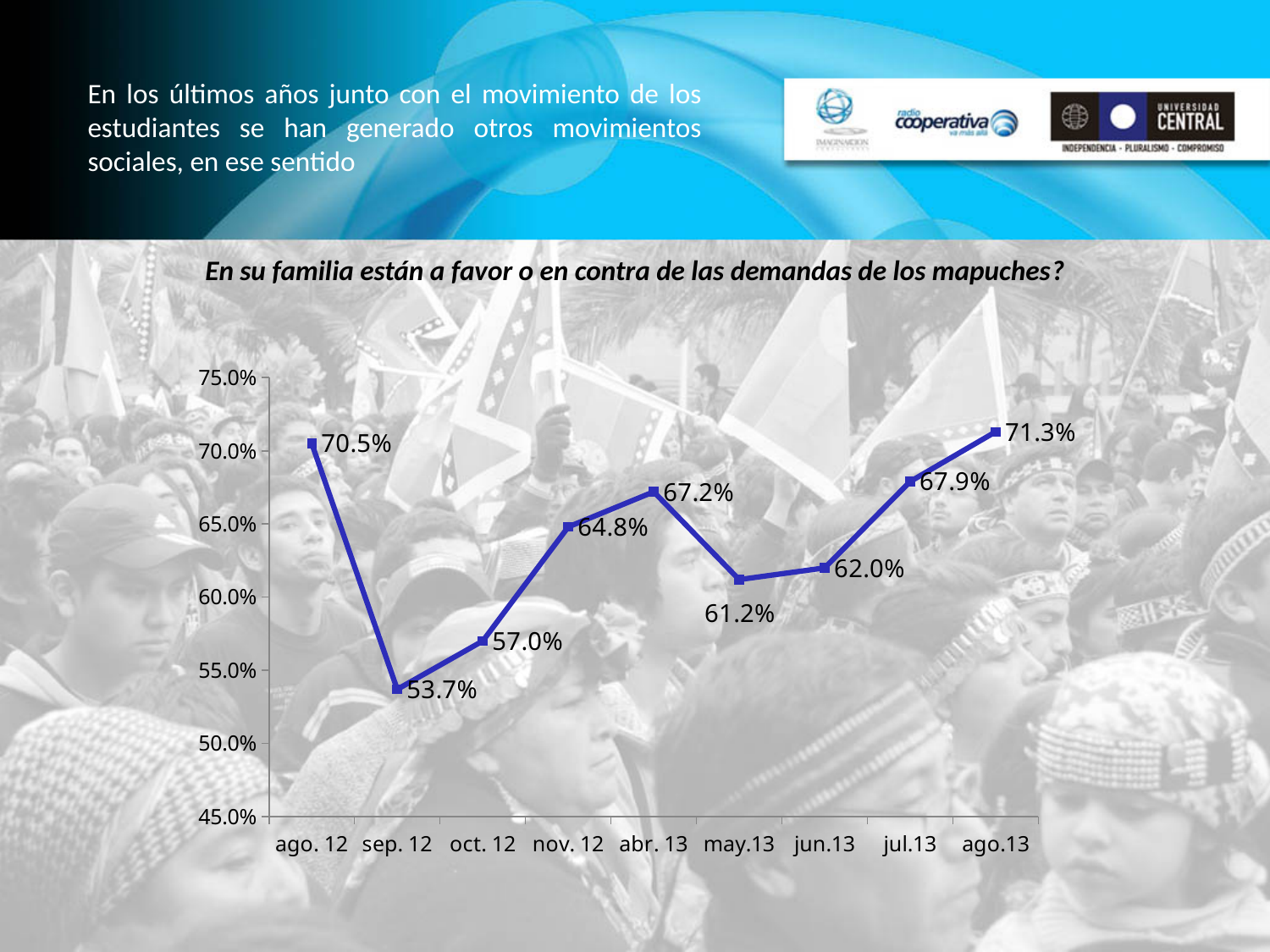
Which is larger, the value for may.13 or the value for nov. 12? nov. 12 What is the value for jul.13? 67.9% What is the value for sep. 12? 53.7% Which month has the lowest value? sep. 12 Does the value rise or fall from may.13 to ago.13? rise Is the value for jun.13 greater or less than 65.0%? less Which month has the highest value? ago.13 What kind of chart is shown on the slide? line chart How many data points are plotted on the chart? 9 What is the value for abr. 13? 67.2% What is the difference between the values for nov. 12 and oct. 12? 7.8% What is the difference between the values for ago.13 and ago. 12? 0.8%